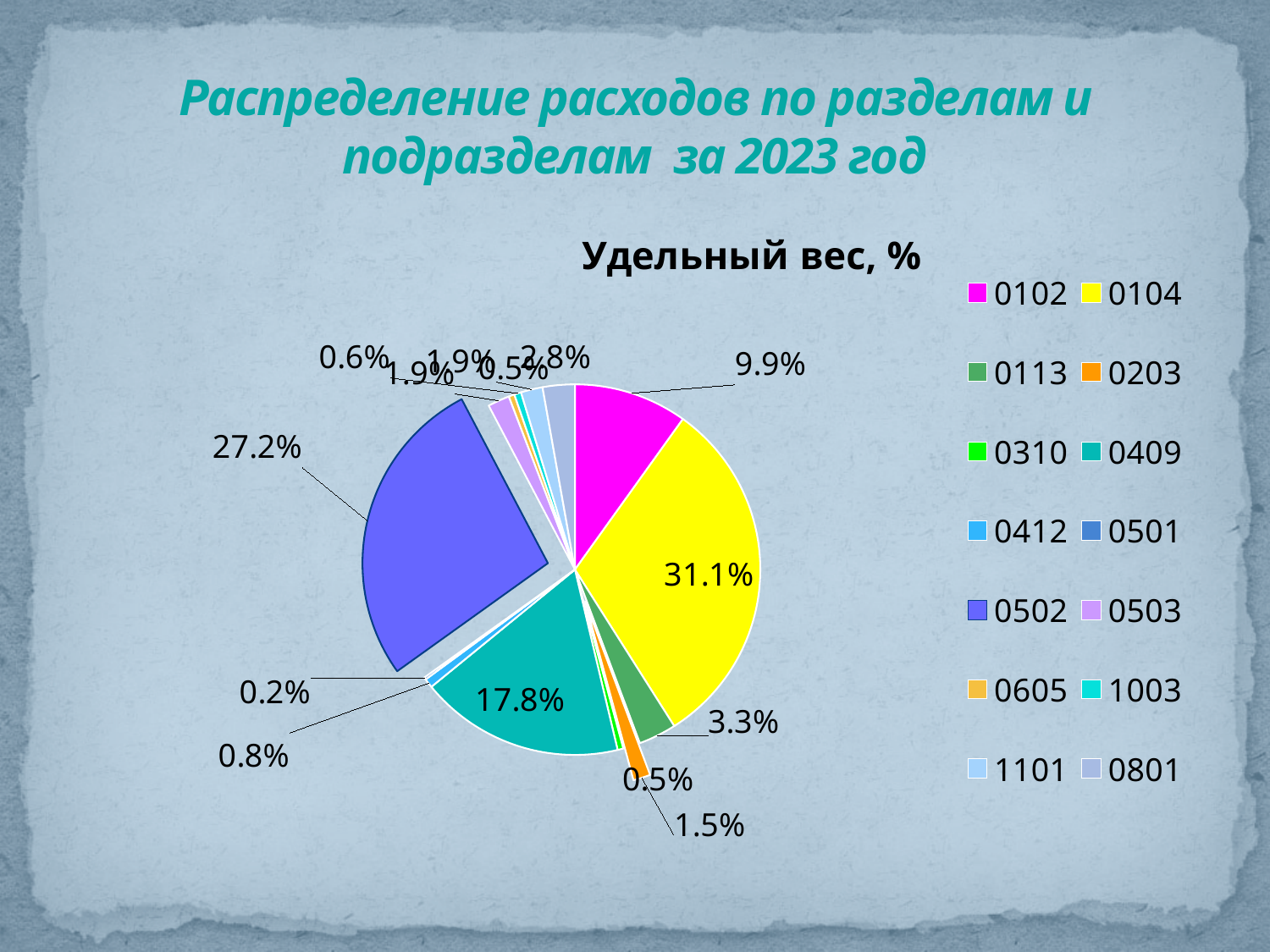
How many categories does the legend list? 14 What is the title of the chart? Удельный вес, % What is the share for category 0104? 31.1% What is the share for category 0502? 27.2% What is the difference in percentage points between the shares of 0104 and 0502? 3.9 What is the difference in percentage points between the shares of 0502 and 0409? 9.4 What kind of chart is shown on the slide? pie chart Which category has the largest share of the pie? 0104 Which has the larger share, 0409 or 0102? 0409 What is the share for category 0102? 9.9% What is the share for category 0409? 17.8% What is the share for category 0113? 3.3%